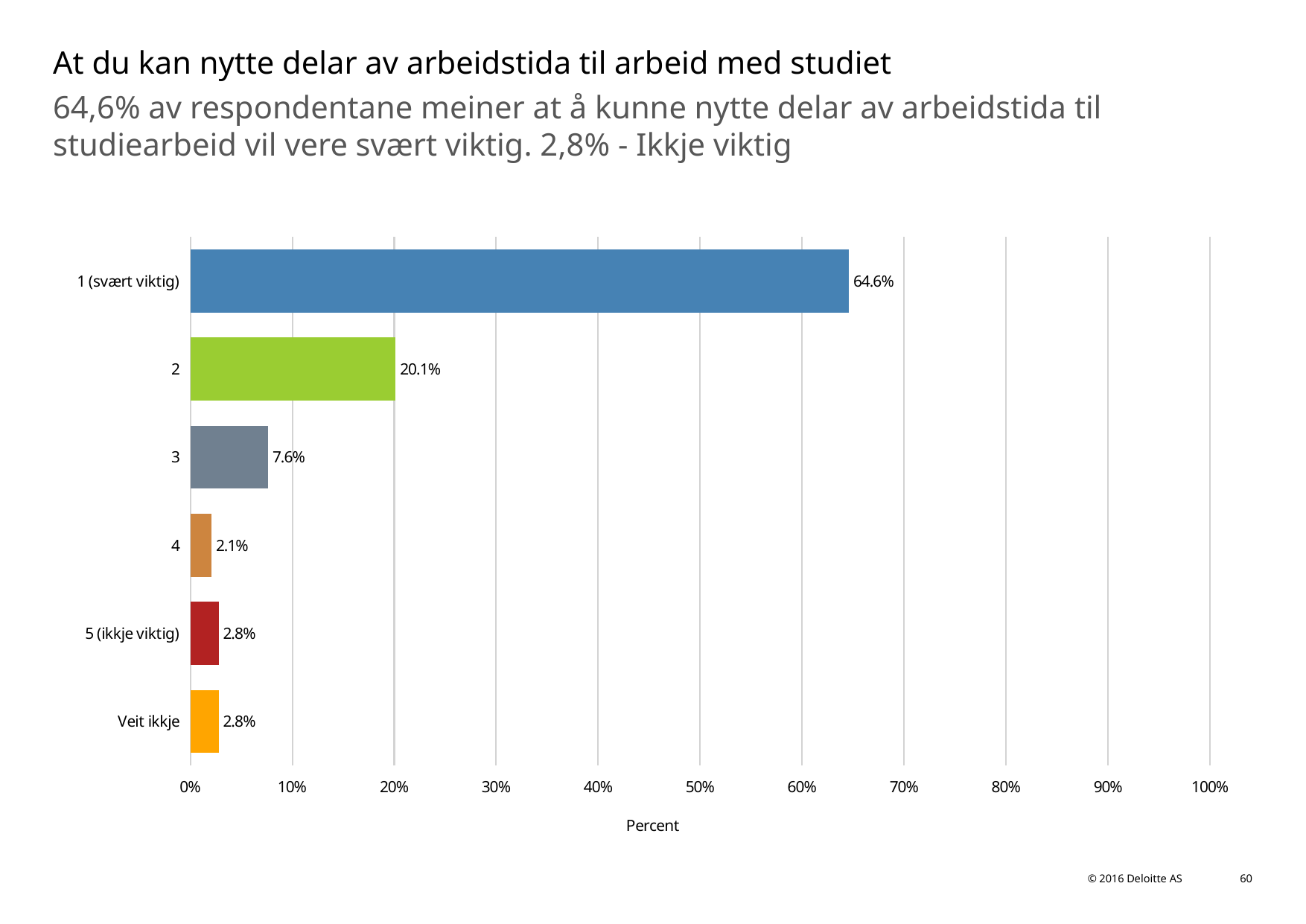
What is the label of the horizontal axis? Percent What is the value for "Veit ikkje"? 2.8% What kind of chart is shown on the slide? bar chart How many categories are shown in the chart? 6 Which category has the lowest value? 4 What is the difference between the values for "1 (svært viktig)" and "2"? 44.5% Which category has the highest value? 1 (svært viktig) What is the difference between the values for "3" and "4"? 5.5% Which is larger, the value for "2" or the value for "3"? 2 Is the value for "2" greater or less than 30%? less What is the value for "1 (svært viktig)"? 64.6% What is the value for category "3"? 7.6%